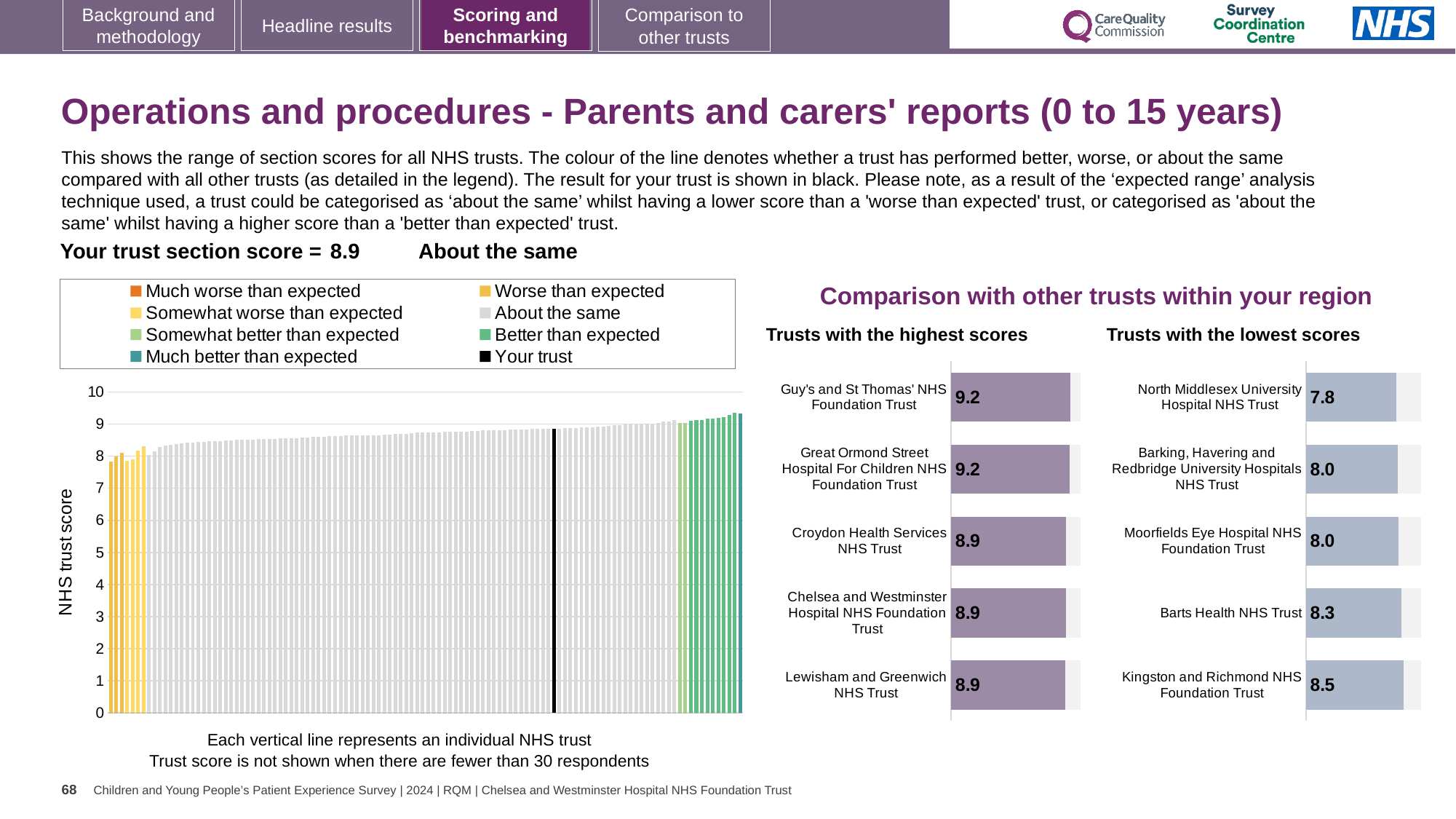
In the 'Trusts with the lowest scores' chart, which has the higher score: Barts Health NHS Trust or Moorfields Eye Hospital NHS Foundation Trust? Barts Health NHS Trust In the 'Trusts with the lowest scores' chart, which trust has the lowest score? North Middlesex University Hospital NHS Trust In the 'Trusts with the highest scores' chart, what is the score for Chelsea and Westminster Hospital NHS Foundation Trust? 8.9 In the 'Trusts with the highest scores' chart, what is the score for Guy's and St Thomas' NHS Foundation Trust? 9.2 In the large chart on the left, is the value for the black bar marked as 'Your trust' greater or less than 8? greater How many trusts are listed in the 'Trusts with the highest scores' chart? 5 In the 'Trusts with the lowest scores' chart, what is the difference between the scores of Kingston and Richmond NHS Foundation Trust and North Middlesex University Hospital NHS Trust? 0.7 In the 'Trusts with the lowest scores' chart, which trust has the highest score? Kingston and Richmond NHS Foundation Trust In the 'Trusts with the lowest scores' chart, what is the score for Barts Health NHS Trust? 8.3 In the 'Trusts with the lowest scores' chart, what is the score for North Middlesex University Hospital NHS Trust? 7.8 What kind of chart is the large chart on the left showing NHS trust scores? Bar chart In the 'Trusts with the highest scores' chart, what is the difference between the scores of Guy's and St Thomas' NHS Foundation Trust and Croydon Health Services NHS Trust? 0.3